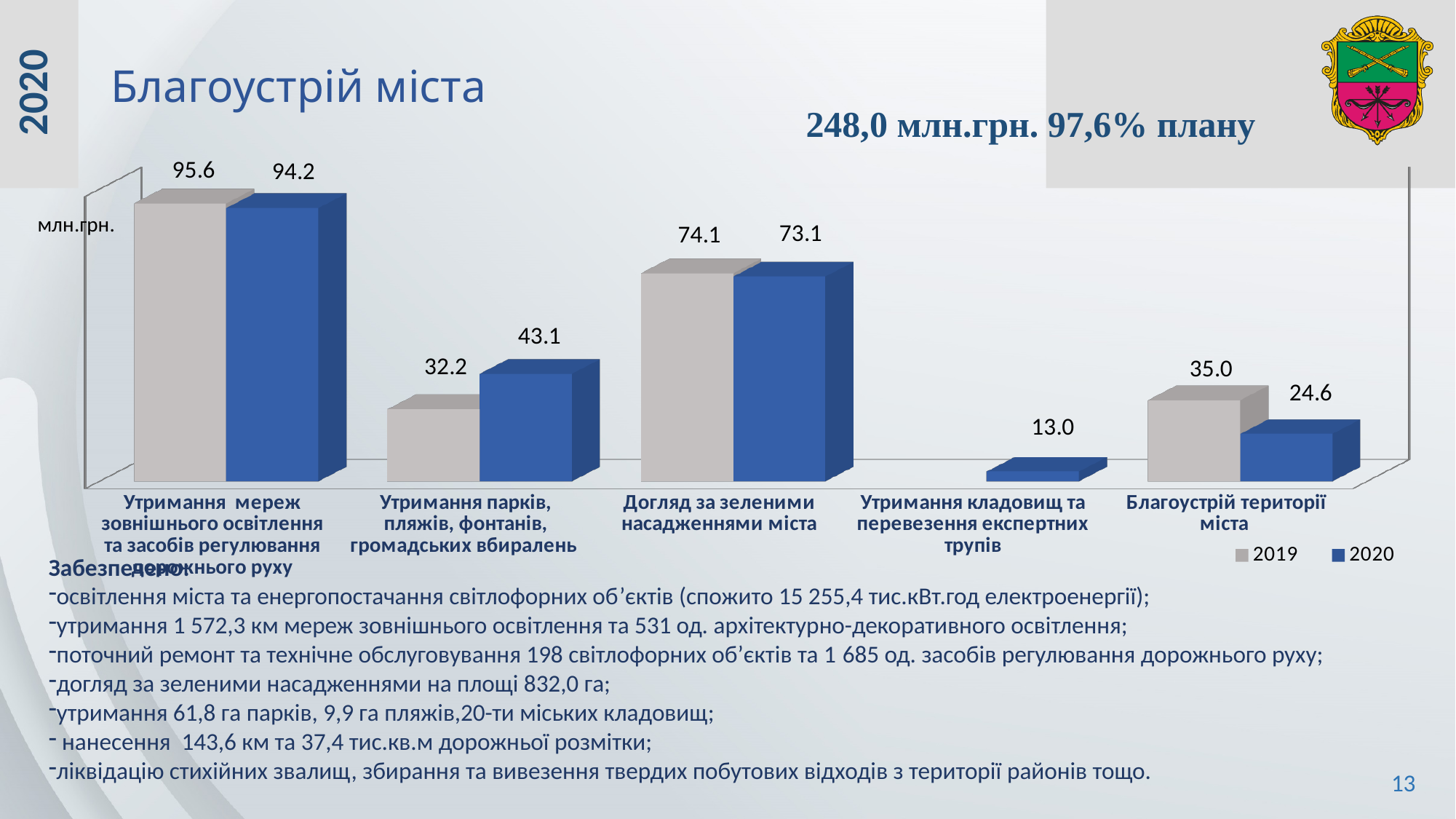
How many categories are shown on the x axis of the chart? 5 What is the 2019 value for "Догляд за зеленими насадженнями міста"? 74.1 What type of chart is shown on the slide? bar chart For "Благоустрій території міста", which year has the larger value, 2019 or 2020? 2019 What is the difference between the 2019 and 2020 values for "Благоустрій території міста"? 10.4 Which category has the highest 2020 value? Утримання мереж зовнішнього освітлення та засобів регулювання дорожнього руху How many series does the chart legend list? 2 Which colour represents the 2019 series in the chart? grey Which category has the lowest 2020 value? Утримання кладовищ та перевезення експертних трупів What is the 2020 value for "Благоустрій території міста"? 24.6 What is the difference between the 2020 and 2019 values for "Утримання парків, пляжів, фонтанів, громадських вбиралень"? 10.9 What is the 2020 value for "Утримання парків, пляжів, фонтанів, громадських вбиралень"? 43.1